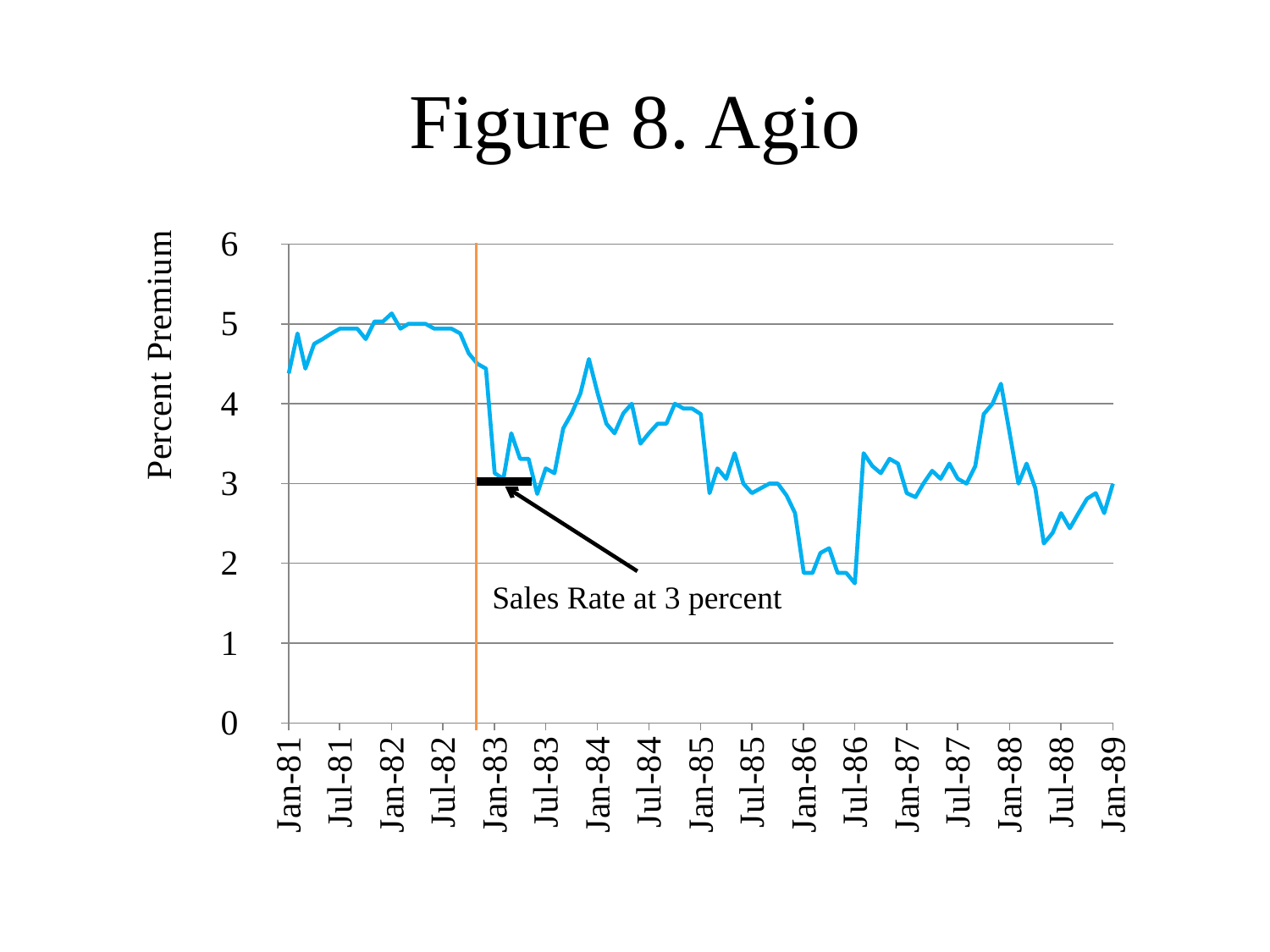
Is the value for Jul-88 greater or less than 3? less Is the value for Jan-81 greater or less than 4? greater What kind of chart is shown on the slide? line chart What text does the annotation with the arrow on the chart say? Sales Rate at 3 percent Overall, do the values rise or fall from Jan-81 to Jan-89? fall Is the value for Jul-86 greater or less than 2? less What is the title of the chart? Figure 8. Agio Which is larger, the value at Jan-81 or the value at Jan-89? Jan-81 In which year does the line reach its highest point? 1982 In which year does the line reach its lowest point? 1986